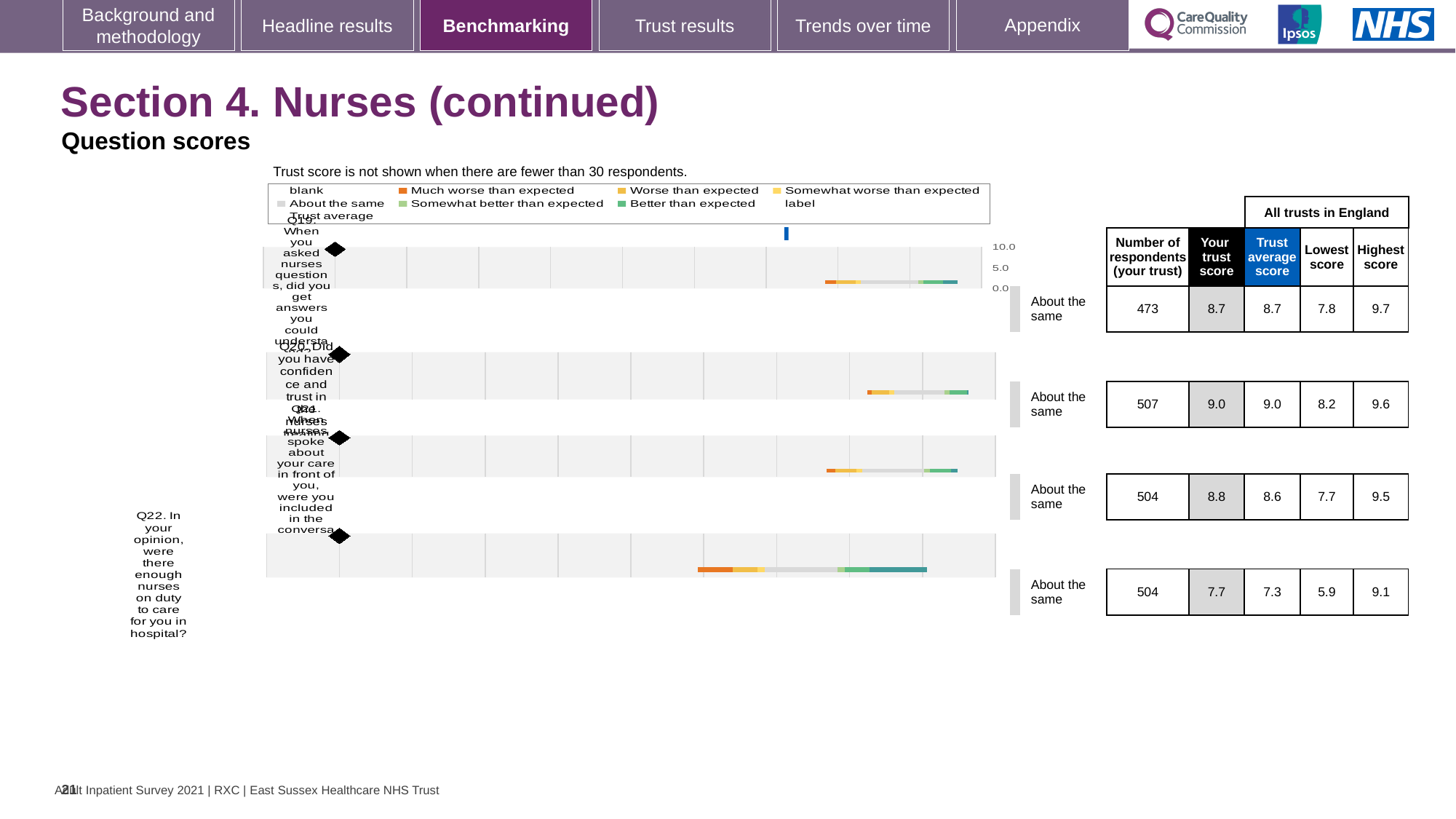
For Q22, what is the difference between the trust's score and the trust average score? 0.4 What is the trust average score for Q20 (confidence and trust in nurses)? 9.0 What is the highest value shown on the chart's score axis? 10.0 What is the lowest score across all trusts in England for Q22? 5.9 For Q21, which is larger: the trust's score or the trust average score? Your trust score Which question has the lowest 'Your trust score'? Q22 How many questions (rows) are plotted in the chart? 4 What is the number of respondents for Q22 (enough nurses on duty)? 504 Which question has the highest 'Your trust score'? Q20 What is the trust's score for Q19 (answers you could understand)? 8.7 What is the highest score across all trusts in England for Q19? 9.7 What kind of chart is used to show the question scores on this slide? bar chart